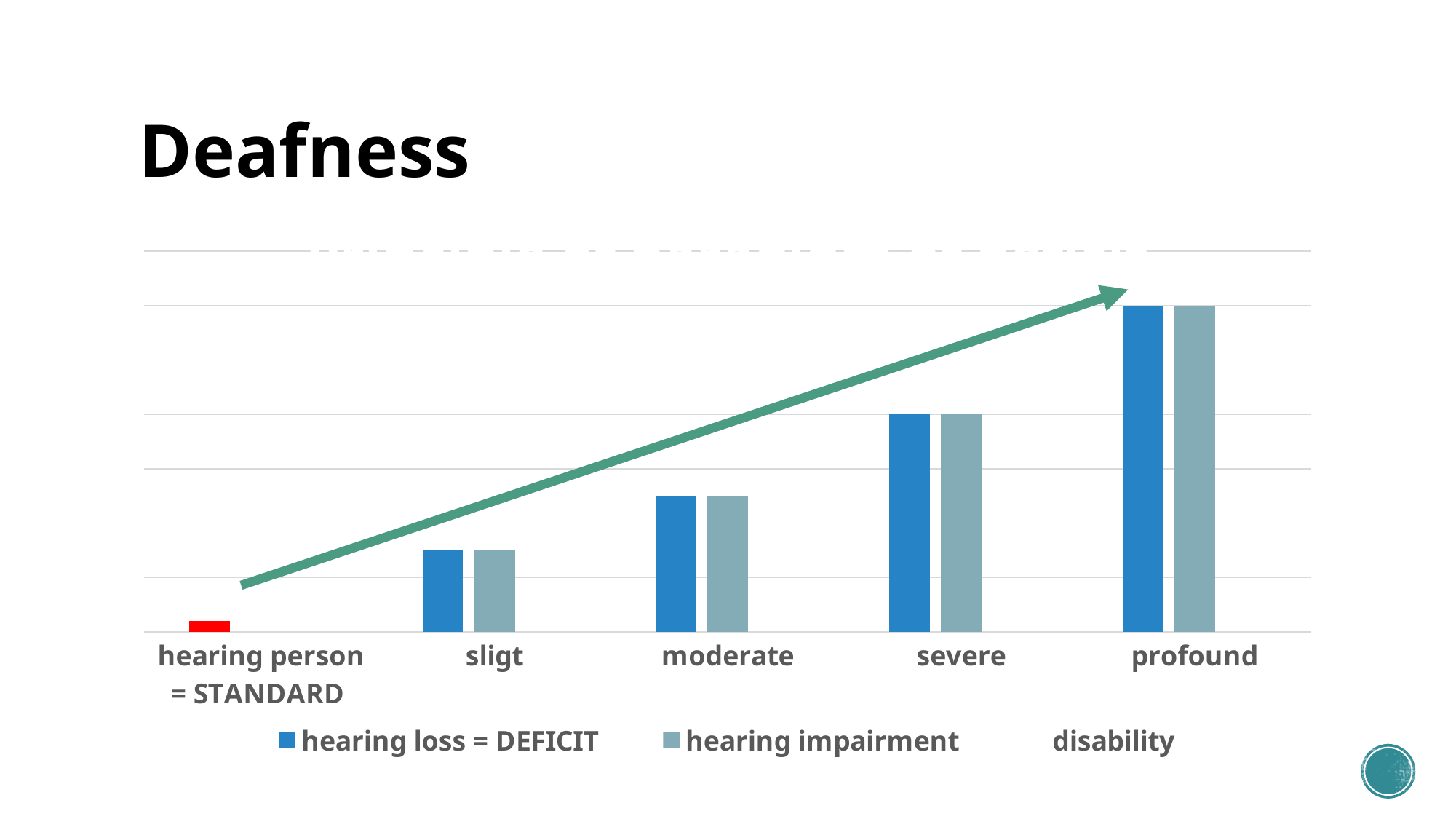
What kind of chart is shown on the slide? bar chart Do the bar heights rise or fall moving from left to right along the x axis? rise Which is taller: the 'hearing loss = DEFICIT' bar for sligt or for moderate? moderate What is the first entry in the chart's legend? hearing loss = DEFICIT Which category has the shortest bar in the chart? hearing person = STANDARD Which category has the tallest bars in the chart? profound How many categories are shown along the x axis of the chart? 5 Which is taller: the 'hearing impairment' bar for sligt or for profound? profound Which is taller: the 'hearing loss = DEFICIT' bar for severe or for moderate? severe What is the title of the slide containing the chart? Deafness How many series does the chart's legend list? 3